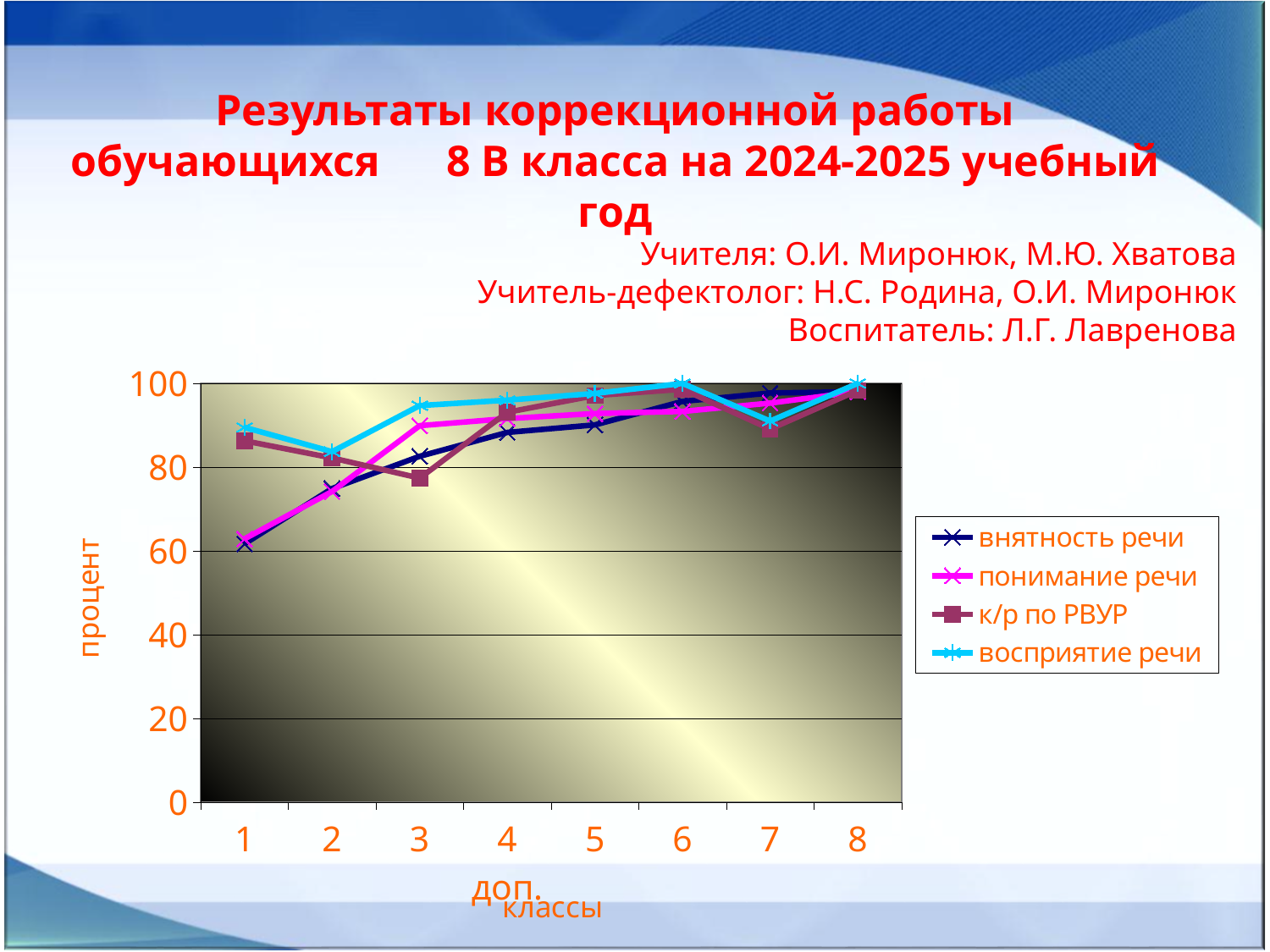
Is the value for внятность речи in class 1 greater or less than 80? less What is the title of the vertical axis? процент Is the value for восприятие речи in class 1 greater or less than 80? greater For the series внятность речи, which class has the lowest value? 1 How many series does the legend list? 4 Is the value for понимание речи in class 2 greater or less than 80? less Do the values for внятность речи rise or fall from class 1 to class 8? rise How many classes are shown along the x axis? 8 In class 3, which series has the higher value: понимание речи or к/р по РВУР? понимание речи What kind of chart is shown on the slide? line chart In class 1, which series has the higher value: восприятие речи or внятность речи? восприятие речи